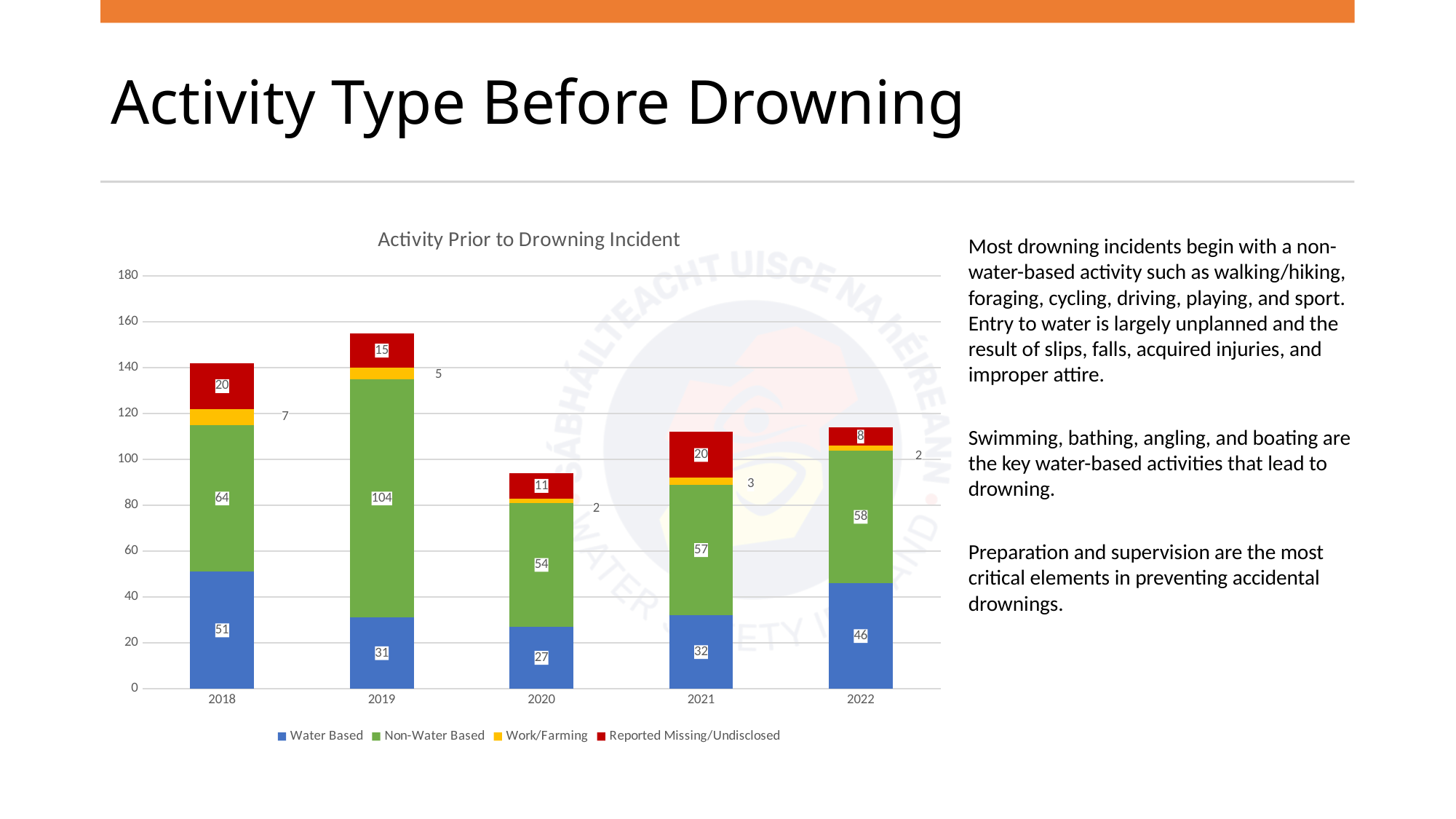
Is the total of the stacked bar for 2019 greater or less than 140? greater What is the title of the chart? Activity Prior to Drowning Incident How many years are shown on the x axis? 5 How many series does the legend list? 4 Which year has the lowest Non-Water Based value? 2020 What type of chart is shown on the slide? Stacked bar chart Which year has the highest Water Based value? 2018 What is the Water Based value for 2022? 46 What is the Non-Water Based value for 2019? 104 What is the total of the stacked bar for 2020? 94 What is the Reported Missing/Undisclosed value for 2020? 11 What is the difference between the Non-Water Based values for 2019 and 2018? 40